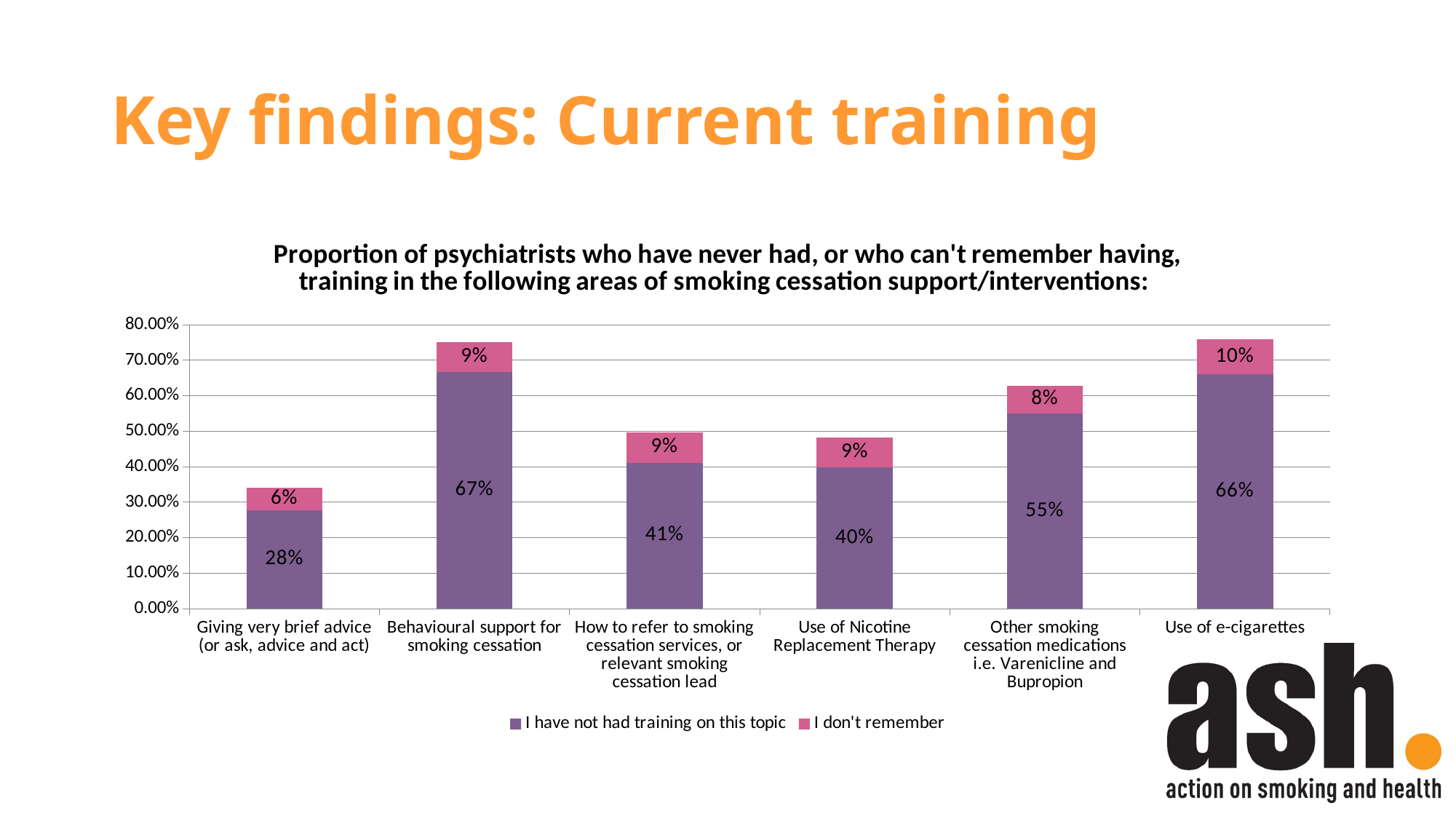
What is the value of 'I have not had training on this topic' for 'Use of Nicotine Replacement Therapy'? 40% What is the value of 'I don't remember' for 'Use of e-cigarettes'? 10% Which legend entry is shown in pink? I don't remember Which is larger: the 'I have not had training on this topic' value for 'Other smoking cessation medications i.e. Varenicline and Bupropion' or for 'Use of Nicotine Replacement Therapy'? Other smoking cessation medications i.e. Varenicline and Bupropion What type of chart is shown on the slide? Stacked bar chart Which category has the highest value for 'I don't remember'? Use of e-cigarettes What is the value of 'I have not had training on this topic' for 'Other smoking cessation medications i.e. Varenicline and Bupropion'? 55% What is the total of the stacked bar for 'Giving very brief advice (or ask, advice and act)'? 34% How many categories are shown on the x axis of the chart? 6 Which category has the lowest value for 'I have not had training on this topic'? Giving very brief advice (or ask, advice and act) What is the difference between the 'I have not had training on this topic' values for 'Behavioural support for smoking cessation' and 'How to refer to smoking cessation services, or relevant smoking cessation lead'? 26% How many series does the chart's legend list? 2